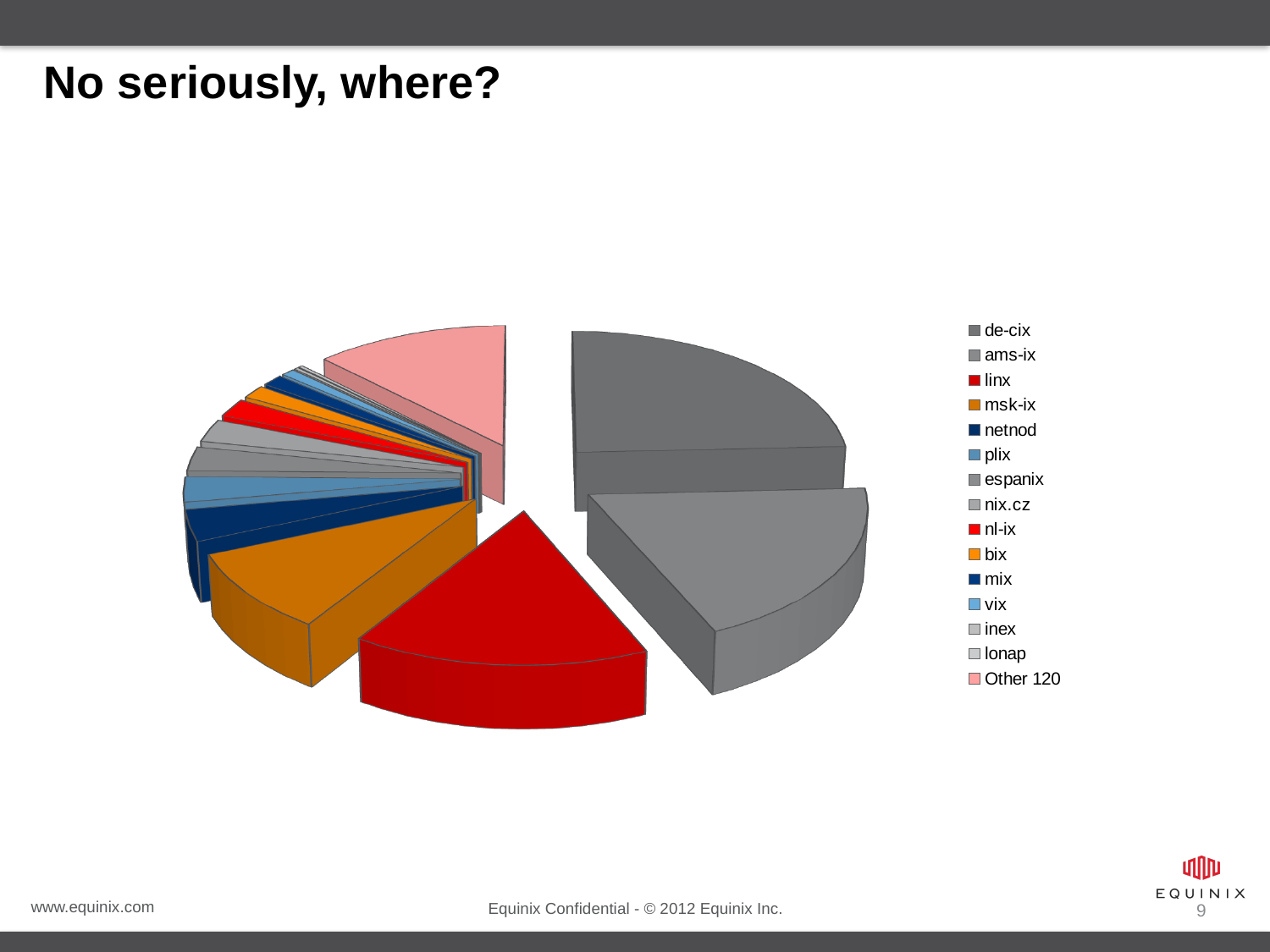
Which slice is larger, de-cix or Other 120? de-cix What is the title of the slide containing the pie chart? No seriously, where? Which slice is larger, de-cix or linx? de-cix Which slice is larger, msk-ix or netnod? msk-ix What is the last entry listed in the pie chart's legend? Other 120 Which category has the largest slice of the pie? de-cix How many slices does the pie chart have? 15 What kind of chart is shown on the slide? pie chart